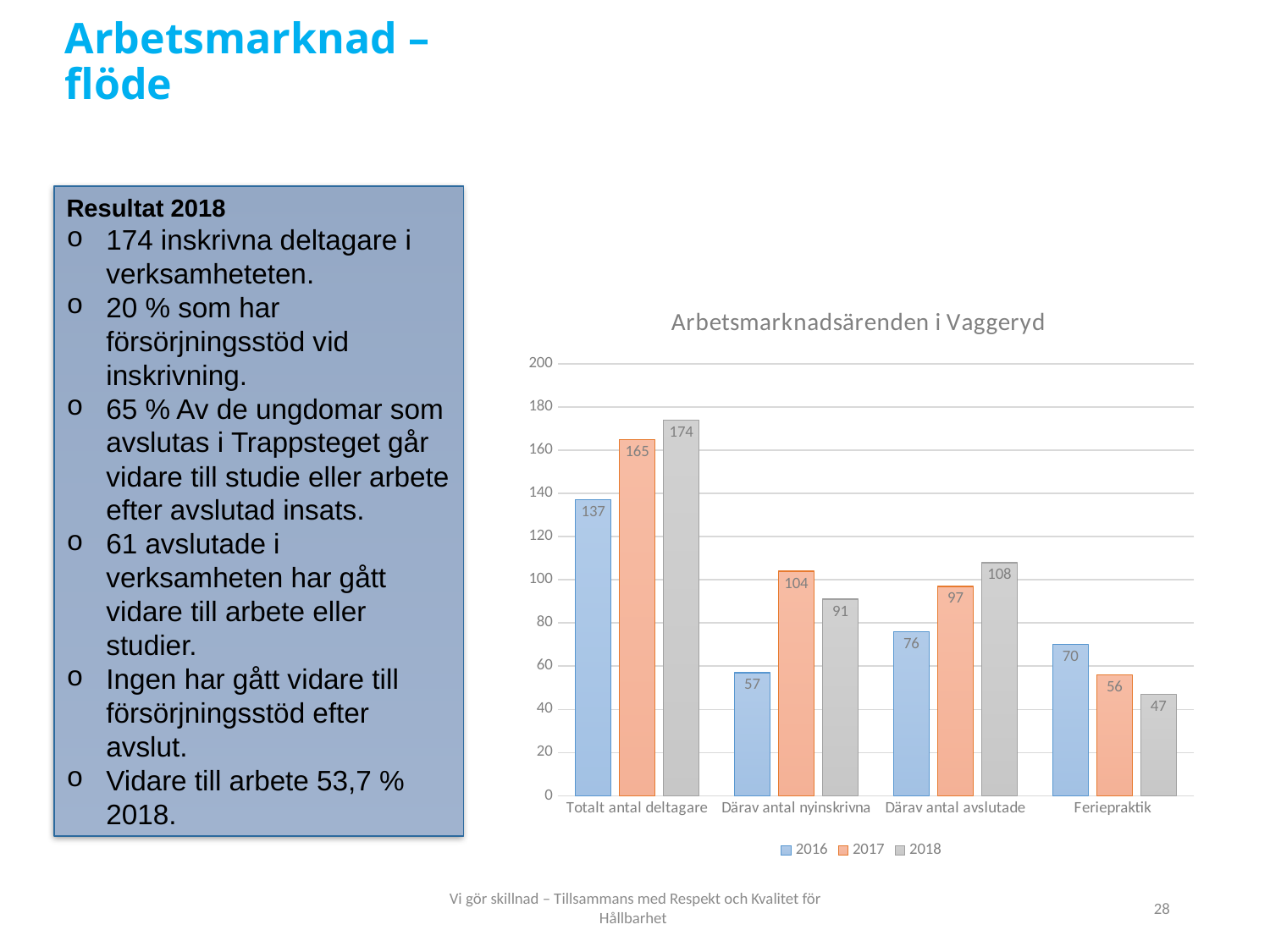
Which year has the highest value in the 'Därav antal avslutade' category? 2018 How many series does the legend list? 3 How many categories are shown on the x axis? 4 What is the value for 2016 in the 'Därav antal nyinskrivna' category? 57 What is the value for 2018 in the 'Totalt antal deltagare' category? 174 What kind of chart is shown on the slide? Bar chart Which is larger: the 2017 value for 'Därav antal nyinskrivna' or the 2018 value for 'Därav antal nyinskrivna'? 2017 Which year has the lowest value in the 'Feriepraktik' category? 2018 What is the value for 2017 in the 'Feriepraktik' category? 56 Do the values for 'Feriepraktik' rise or fall from 2016 to 2018? Fall What is the difference between the 2018 and 2016 values for 'Totalt antal deltagare'? 37 What is the title of the chart? Arbetsmarknadsärenden i Vaggeryd